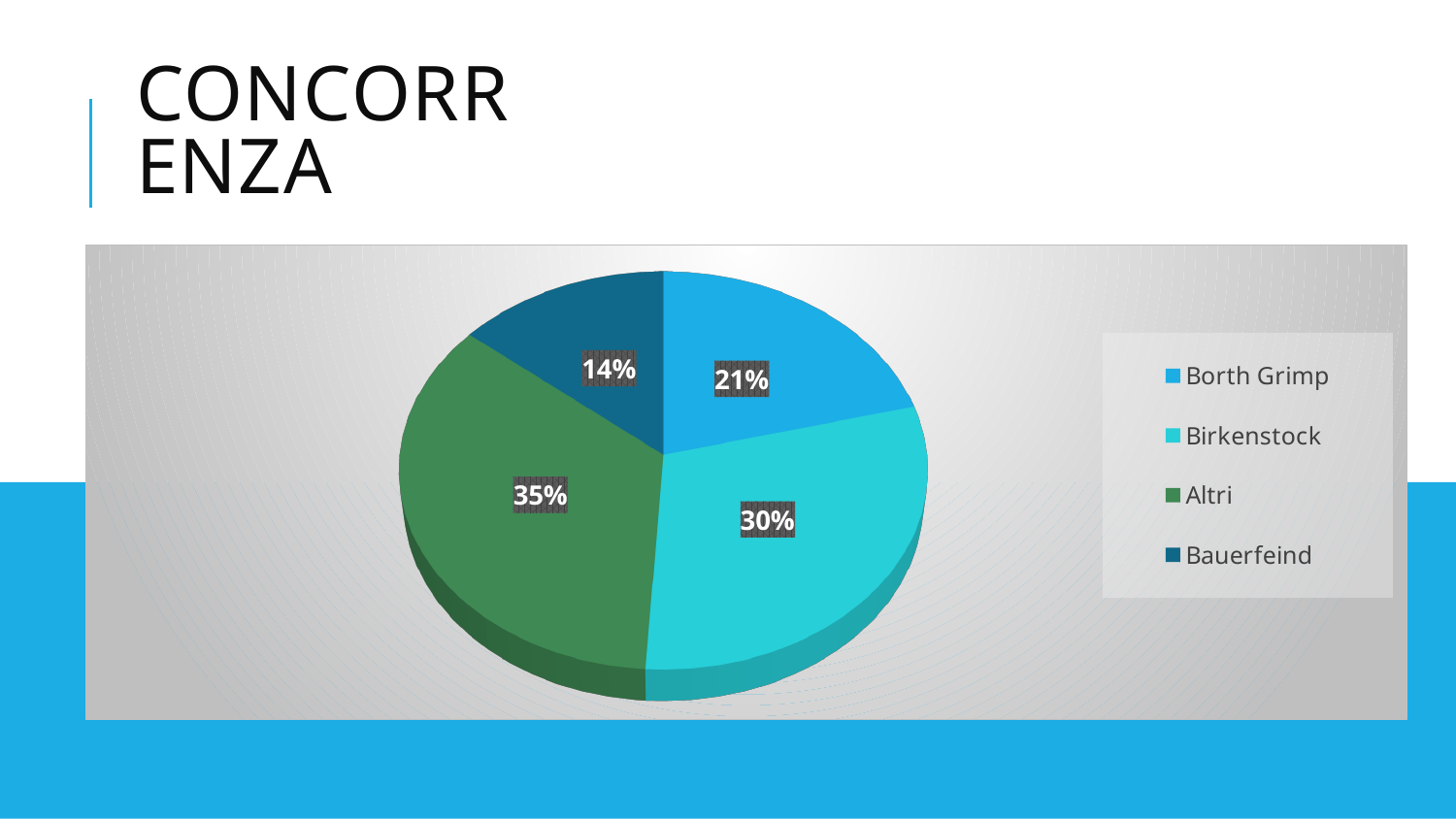
Which category has the largest slice of the pie? Altri What kind of chart is shown on the slide? Pie chart What is the difference in percentage points between Birkenstock and Borth Grimp? 9 What share of the pie does Bauerfeind have? 14% Which category is shown in dark green in the legend? Altri Which category has the smallest slice of the pie? Bauerfeind What share of the pie does Altri have? 35% What is the difference in percentage points between Altri and Bauerfeind? 21 How many categories does the pie chart have? 4 What share of the pie does Birkenstock have? 30% Which is larger, the share for Birkenstock or the share for Borth Grimp? Birkenstock